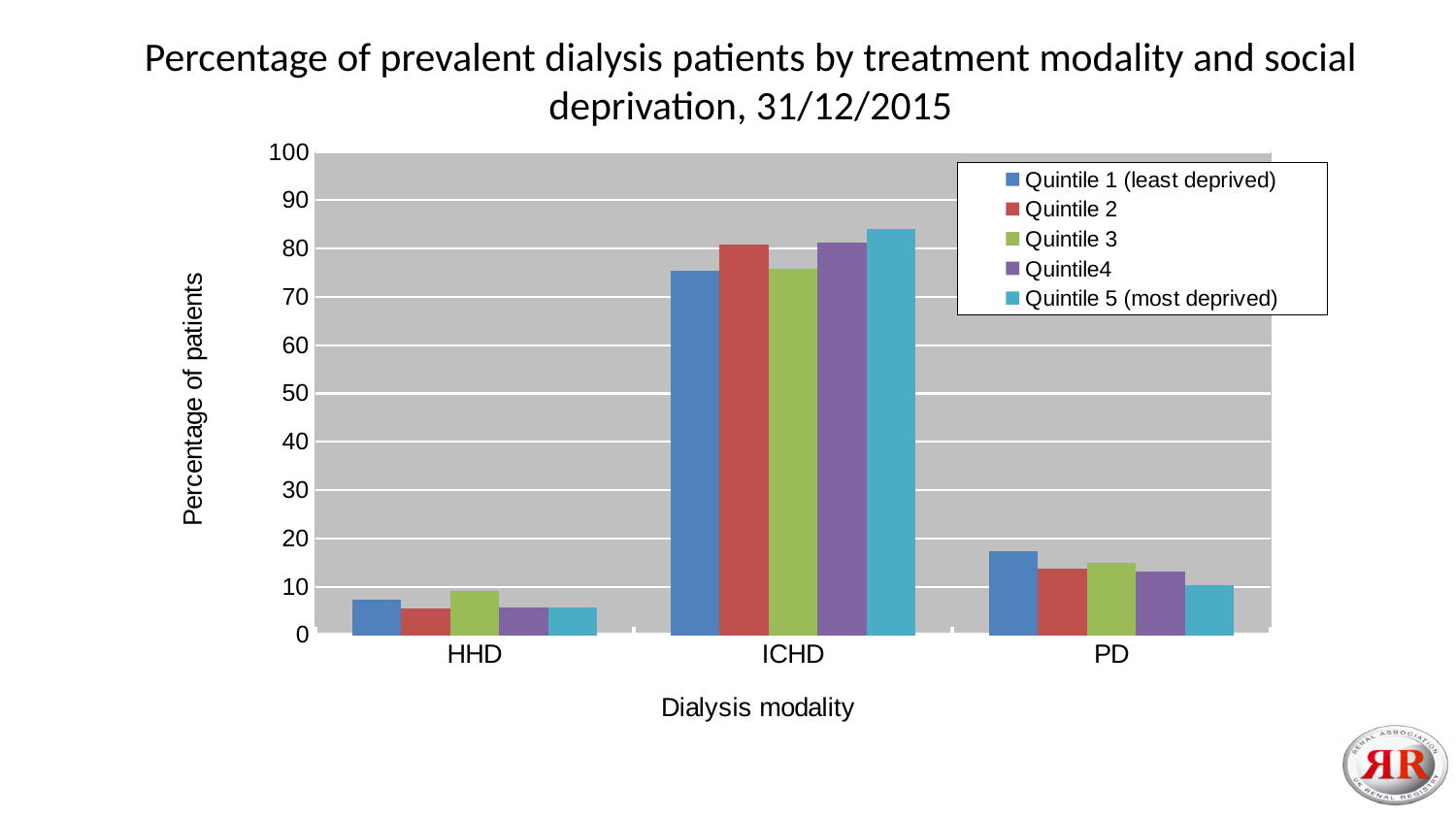
Within the ICHD category, which quintile has the highest percentage of patients? Quintile 5 (most deprived) Within the PD category, which quintile has the highest percentage of patients? Quintile 1 (least deprived) Within the PD category, which quintile has the lowest percentage of patients? Quintile 5 (most deprived) In the ICHD category, which is larger: the value for Quintile 1 (least deprived) or Quintile 2? Quintile 2 Within the HHD category, which quintile has the highest percentage of patients? Quintile 3 Is the value for Quintile 1 (least deprived) in the HHD category greater or less than 10? less What kind of chart is shown on the slide? bar chart What is the title of the y axis? Percentage of patients Is the value for Quintile 1 (least deprived) in the ICHD category greater or less than 80? less Is the value for Quintile 5 (most deprived) in the ICHD category greater or less than 80? greater How many series does the legend list? 5 How many dialysis modality categories are shown on the x axis? 3